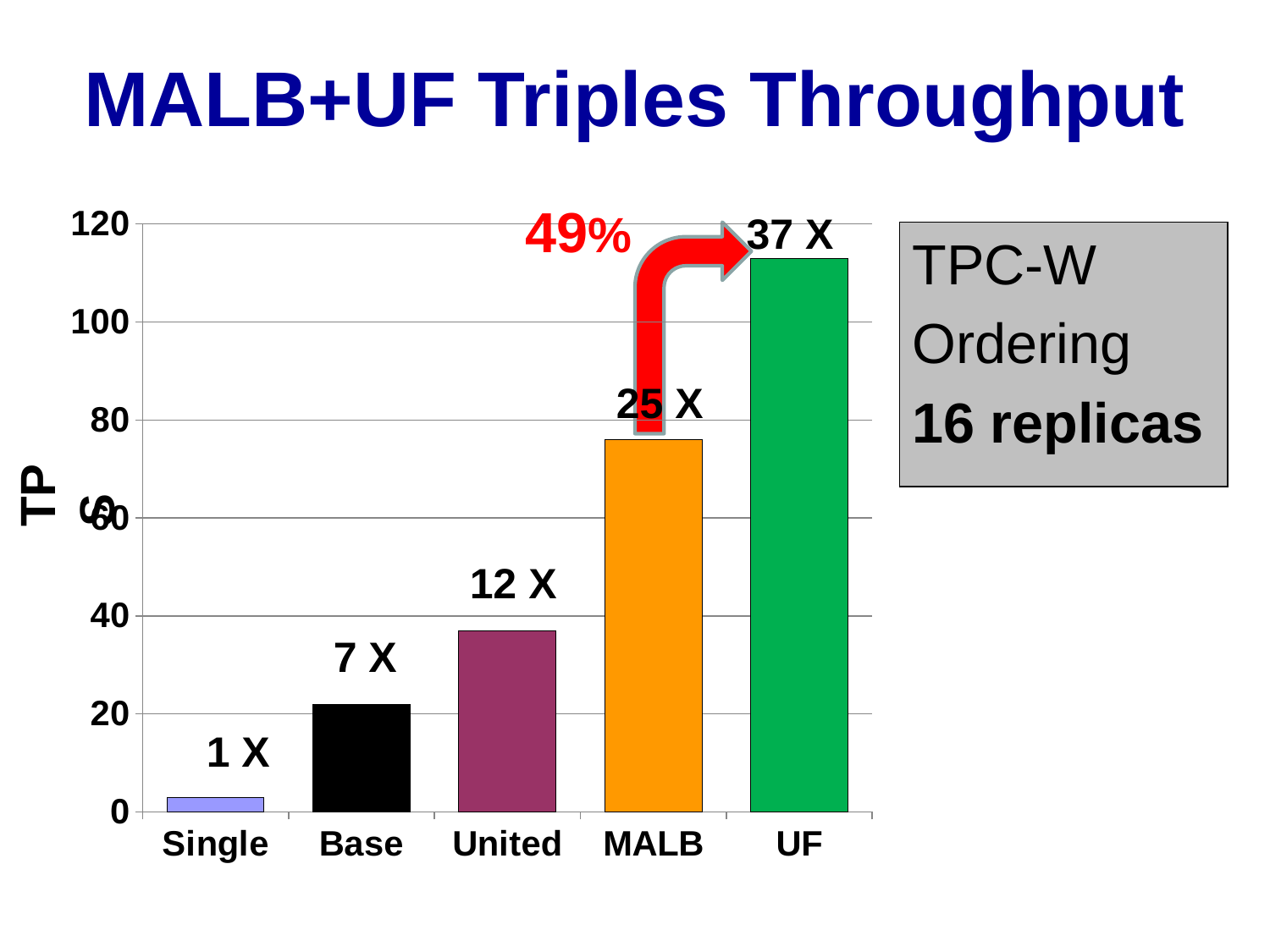
Which bar is taller, United or MALB? MALB What kind of chart is shown on the slide? bar chart How many bars (categories) are shown in the chart? 5 Which category has the lowest bar? Single What label is printed above the United bar? 12 X What label is printed above the UF bar? 37 X Which category has the highest bar? UF Is the value for UF greater or less than 100? greater What percentage is written in red next to the arrow between the MALB and UF bars? 49% What label is printed above the MALB bar? 25 X Is the value for MALB greater or less than 80? less What label is printed above the Base bar? 7 X